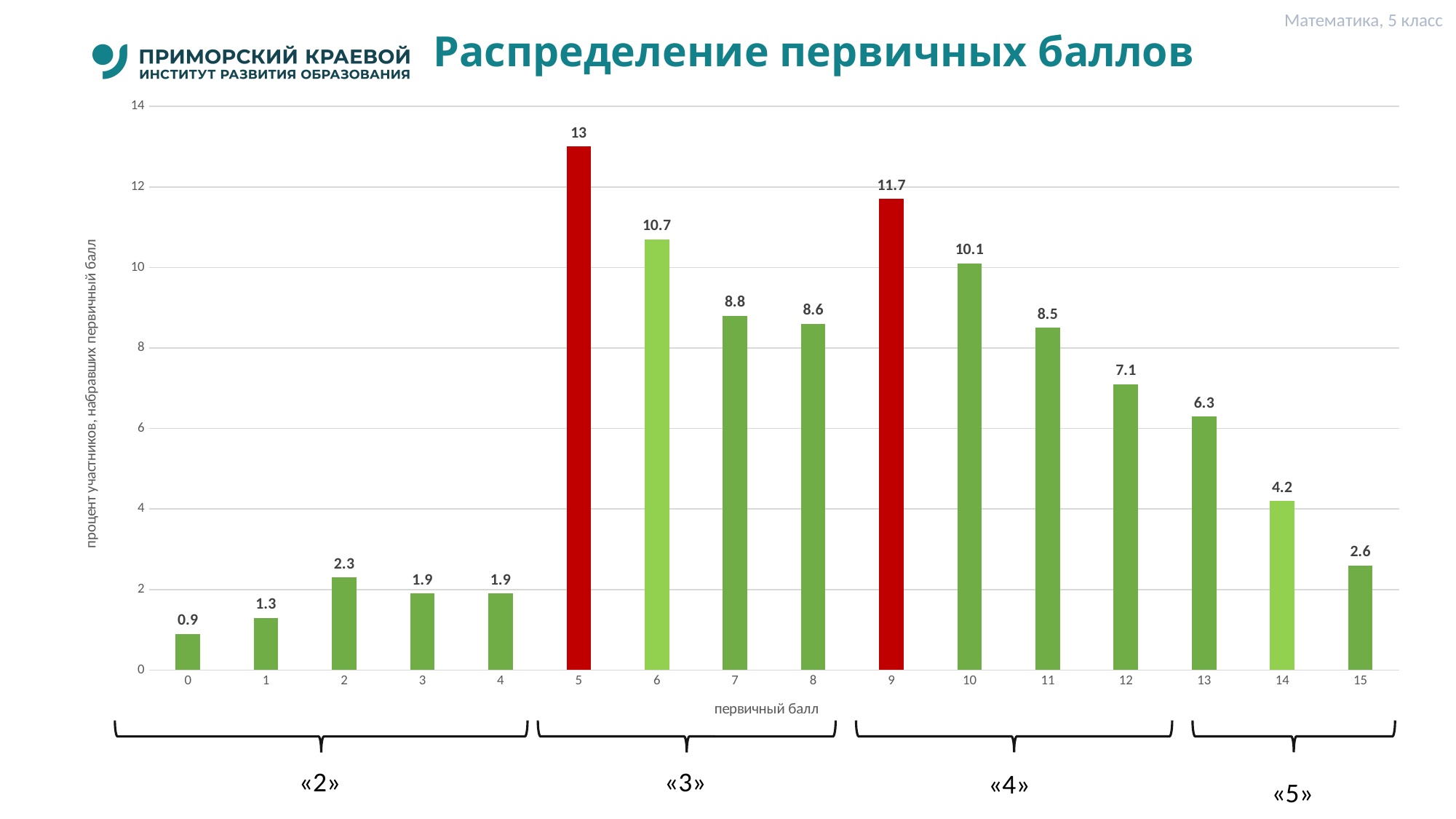
Which is larger, the value for primary score 6 or primary score 10? 6 What is the value for primary score 9? 11.7 What is the title of the chart? Распределение первичных баллов Which primary score has the lowest value? 0 What kind of chart is shown on the slide? bar chart How many primary score categories are shown on the x axis? 16 What is the value for primary score 12? 7.1 Is the value for primary score 11 greater or less than 8? greater What is the value for primary score 5? 13 Which primary score has the highest value? 5 What is the difference between the values for primary scores 13 and 14? 2.1 What is the difference between the values for primary scores 5 and 9? 1.3